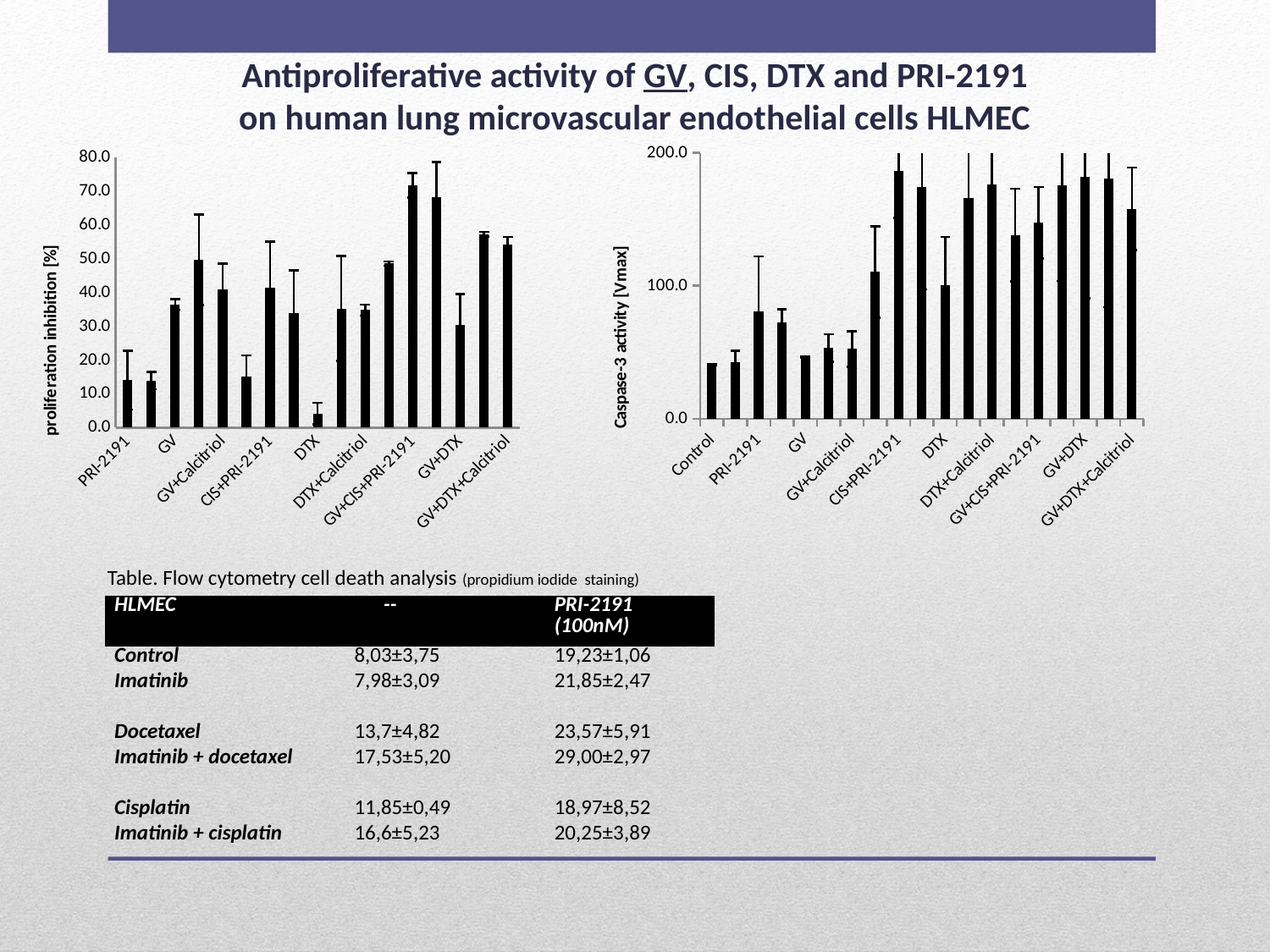
What kind of chart is the right chart on the slide? bar chart What is the y-axis label of the right chart? Caspase-3 activity [Vmax] What is the y-axis label of the left chart? proliferation inhibition [%] In the right chart (Caspase-3 activity), is the tallest bar greater or less than 150? greater What kind of chart is the left chart on the slide? bar chart In the left chart (proliferation inhibition), is the shortest bar greater or less than 10? less What is the highest tick value on the y-axis of the right chart? 200.0 How many charts are shown on the slide? 2 In the left chart (proliferation inhibition), is the tallest bar greater or less than 60? greater